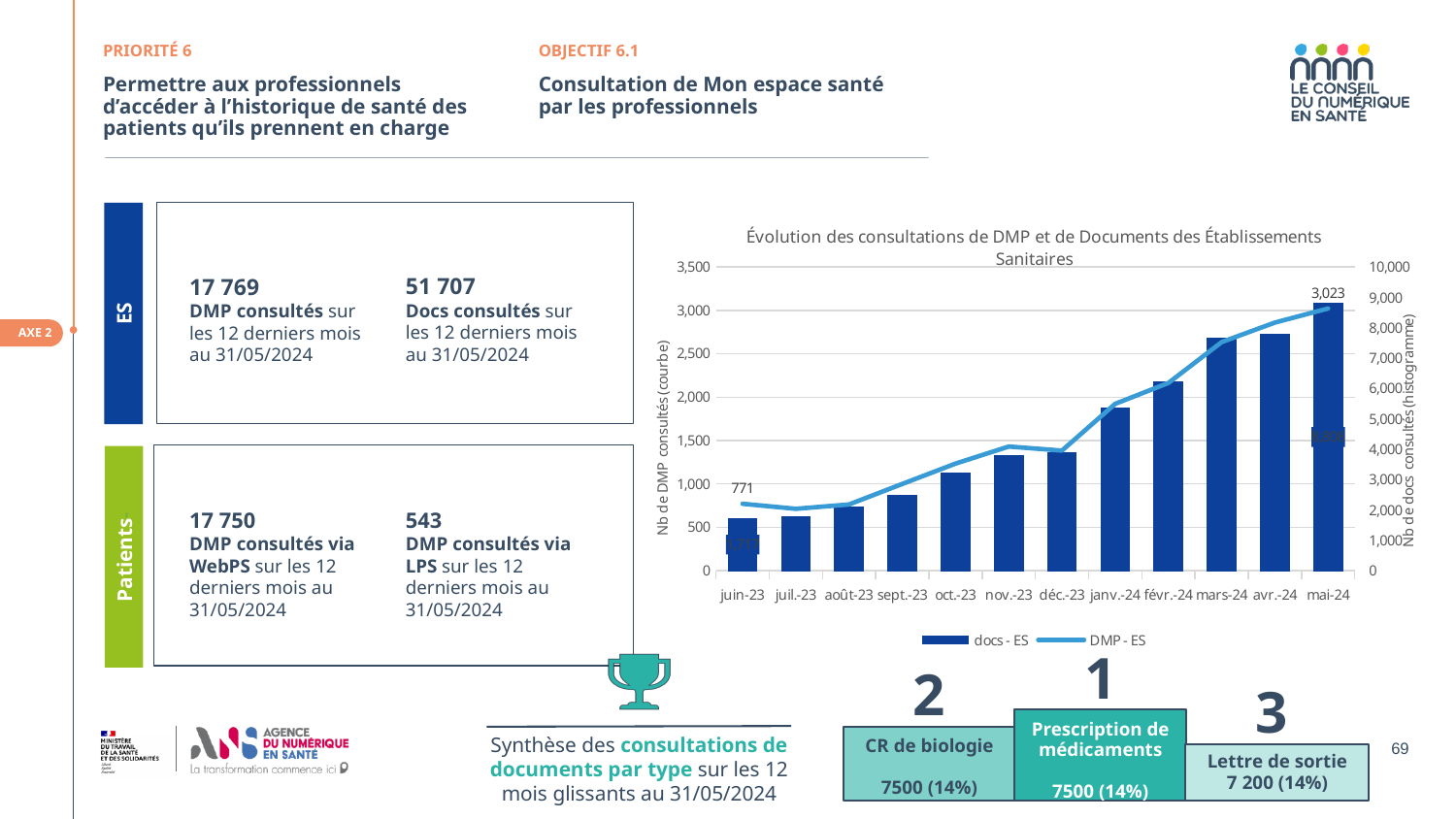
How many months are shown on the x axis of the chart? 12 What is the difference between the DMP - ES values for mai-24 and juin-23? 2,252 Does the DMP - ES line generally rise or fall from juin-23 to mai-24? Rise Which month has the larger docs - ES bar, juin-23 or mai-24? mai-24 What is the value of the DMP - ES line for mai-24? 3,023 What is the value of the DMP - ES line for juin-23? 771 Is the docs - ES bar for juin-23 greater or less than 2,000? less In which month is the DMP - ES line at its highest? mai-24 Is the docs - ES bar for mai-24 greater or less than 8,000? greater How many series does the chart legend list? 2 What are the two series named in the chart legend? docs - ES and DMP - ES What kind of chart is shown on the slide? Combined bar and line chart